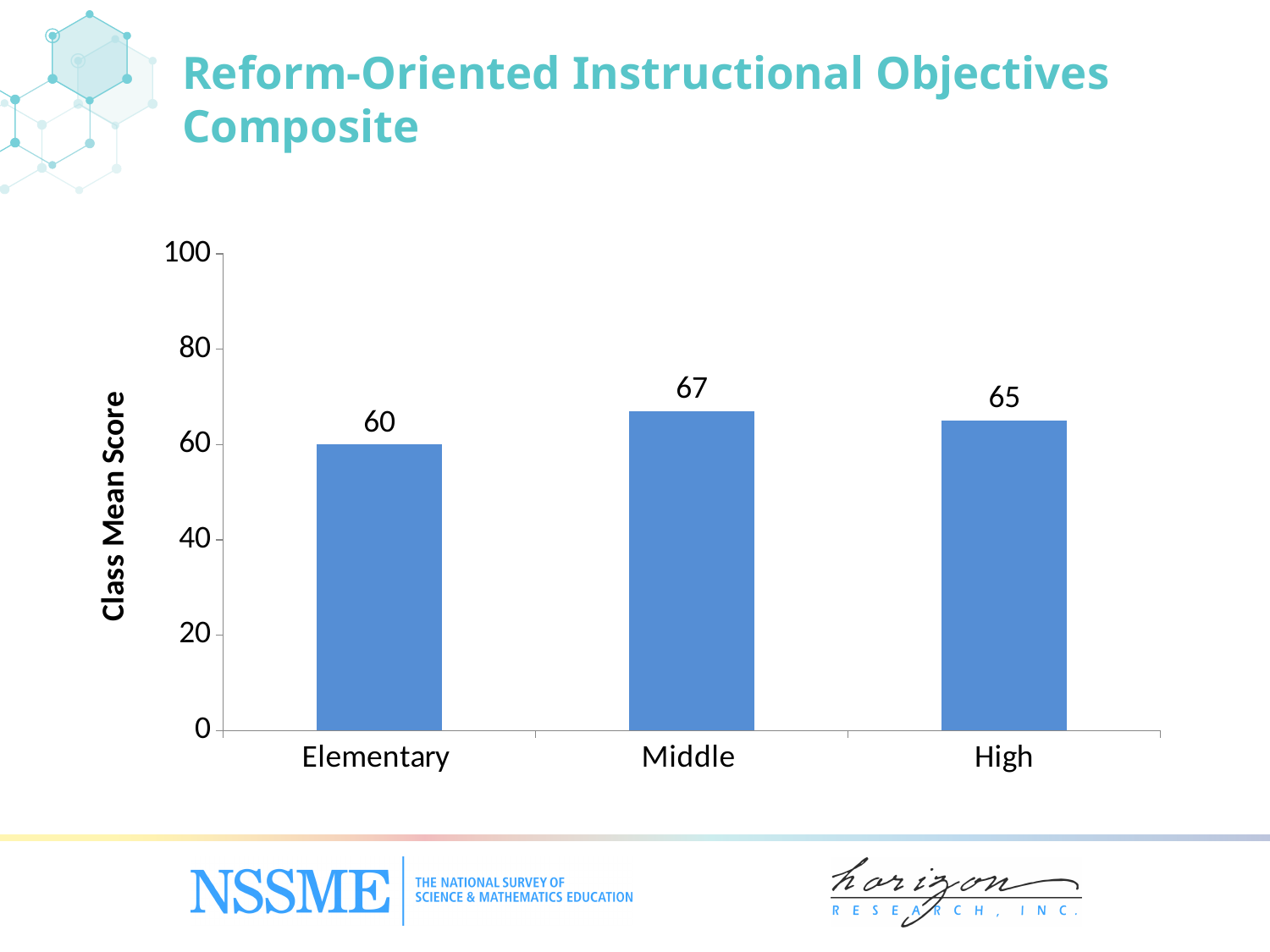
What is the class mean score for High? 65 Which has a higher class mean score, Elementary or High? High Which grade level has the lowest class mean score? Elementary What is the class mean score for Middle? 67 How many grade levels are shown on the chart? 3 What is the difference between the class mean scores for Middle and Elementary? 7 What is the label on the vertical axis of the chart? Class Mean Score Which grade level has the highest class mean score? Middle What is the class mean score for Elementary? 60 Is the value for Middle greater or less than 80? less What kind of chart is shown on the slide? bar chart What is the difference between the class mean scores for Middle and High? 2